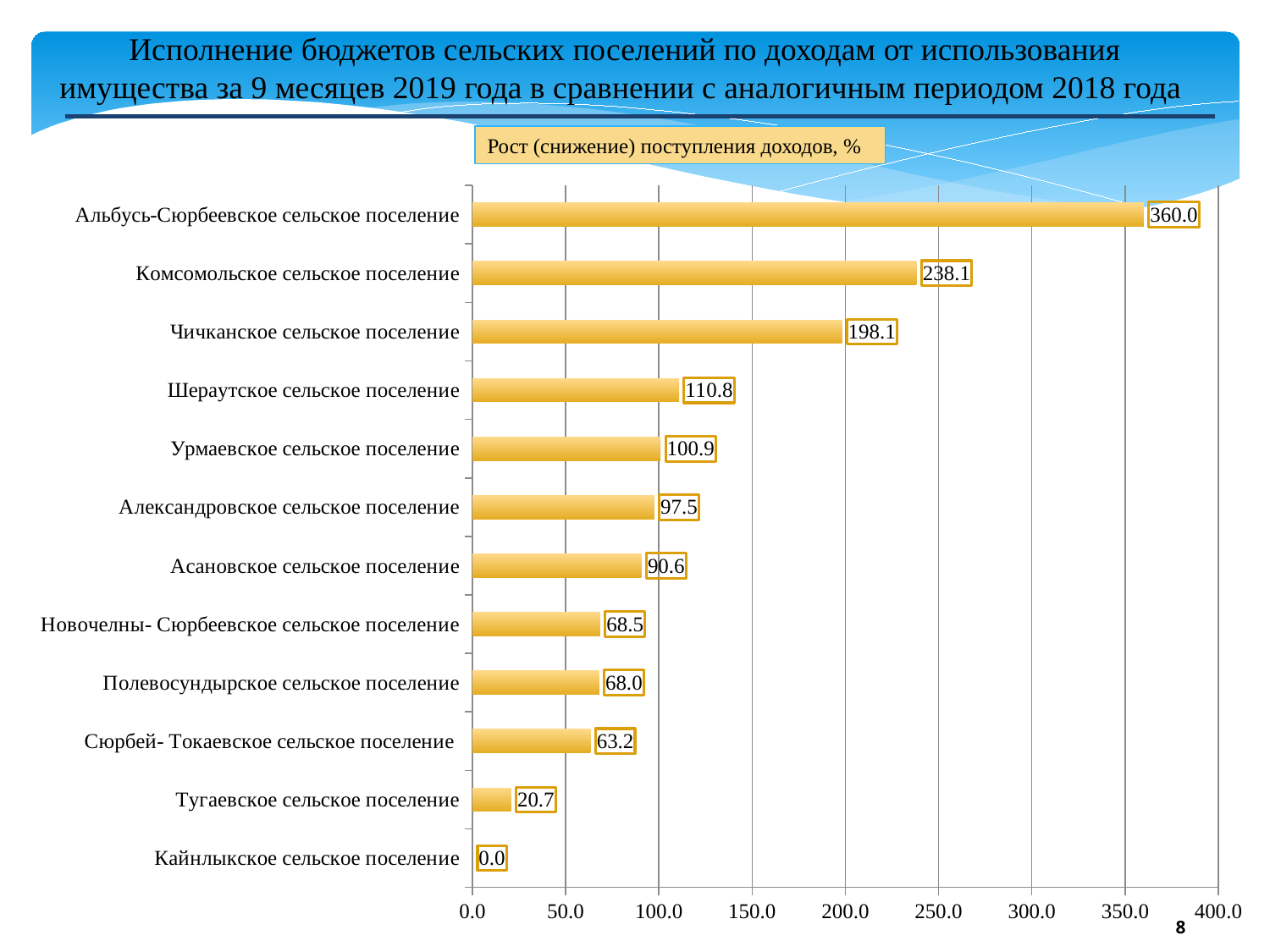
What kind of chart is shown on the slide? bar chart Which settlement has the lowest value? Кайнлыкское сельское поселение What is the value for Урмаевское сельское поселение? 100.9 Which settlement has the highest value? Альбусь-Сюрбеевское сельское поселение What is the value for Тугаевское сельское поселение? 20.7 What is the value for Комсомольское сельское поселение? 238.1 Which is larger, the value for Чичканское сельское поселение or the value for Шераутское сельское поселение? Чичканское сельское поселение What is the difference between the values for Альбусь-Сюрбеевское сельское поселение and Комсомольское сельское поселение? 121.9 Is the value for Асановское сельское поселение greater or less than 100.0? less How many settlements are shown in the chart? 12